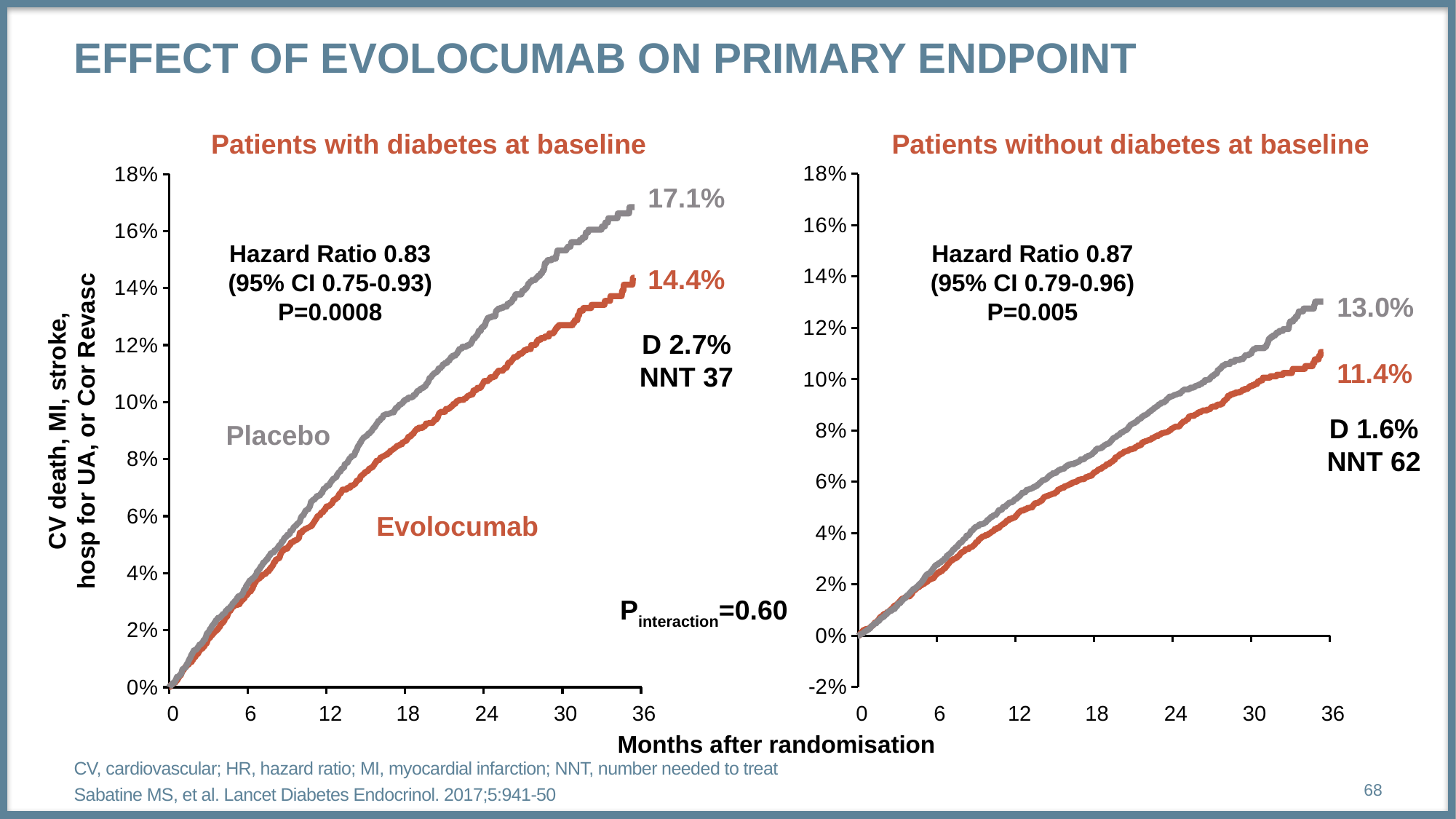
In the 'Patients with diabetes at baseline' chart, which curve ends higher, Placebo or Evolocumab? Placebo In the 'Patients without diabetes at baseline' chart, what is the final value shown for the Placebo curve? 13.0% How many curves are plotted in the 'Patients with diabetes at baseline' chart? 2 In the 'Patients without diabetes at baseline' chart, what is the final value shown for the Evolocumab curve? 11.4% In the 'Patients without diabetes at baseline' chart, what is the difference between the final Placebo and Evolocumab values? 1.6% In the 'Patients with diabetes at baseline' chart, do the curves rise or fall as months after randomisation increase? Rise In the 'Patients with diabetes at baseline' chart, what is the difference between the final Placebo and Evolocumab values? 2.7% What hazard ratio is shown in the 'Patients without diabetes at baseline' chart? 0.87 In the 'Patients with diabetes at baseline' chart, is the Placebo value at 24 months greater or less than 10%? greater In the 'Patients with diabetes at baseline' chart, what is the final value shown for the Evolocumab curve? 14.4% What kind of chart is used in the 'Patients without diabetes at baseline' panel? Line chart In the 'Patients with diabetes at baseline' chart, what is the final value shown for the Placebo curve? 17.1%